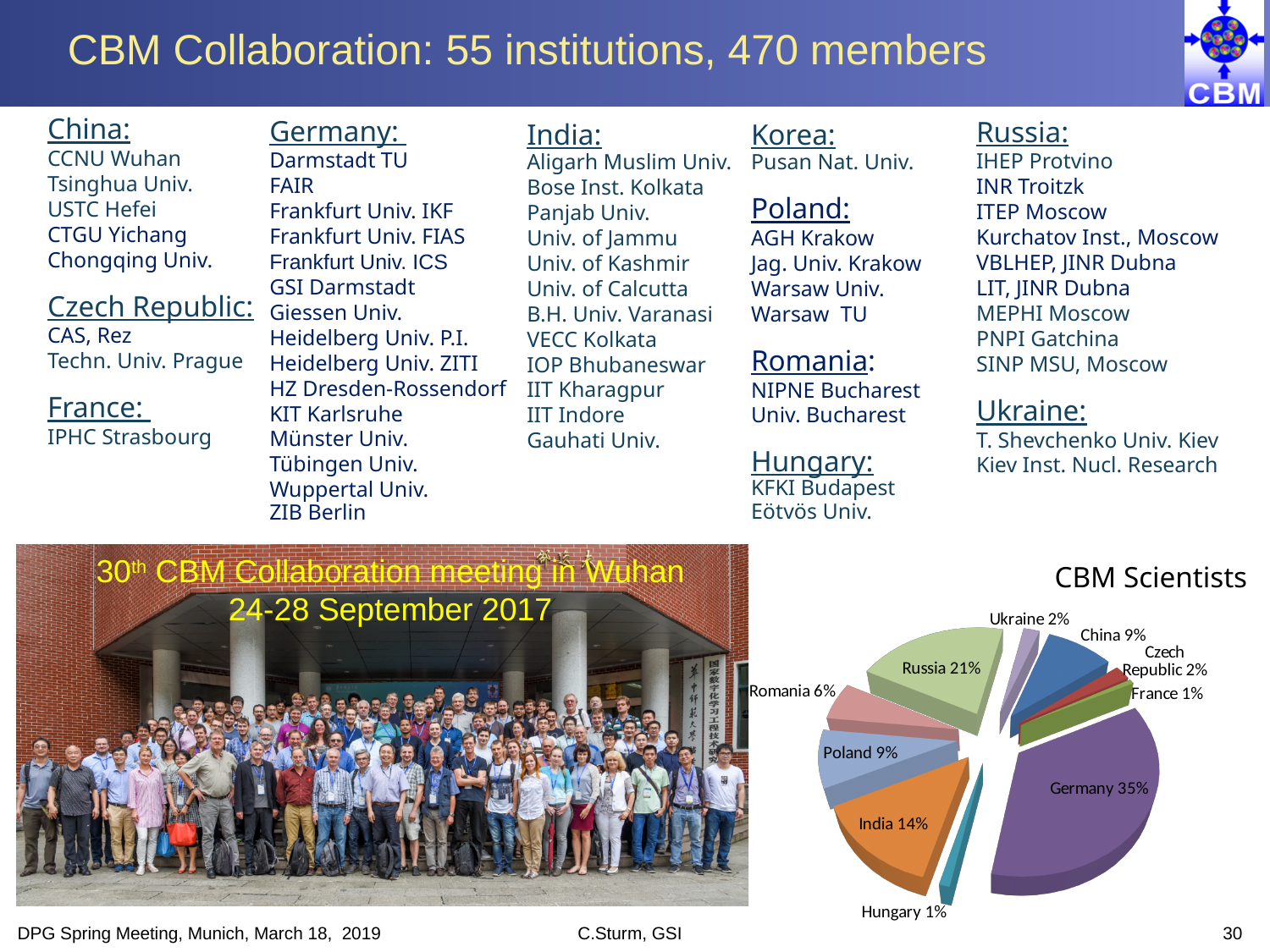
What kind of chart is used to show the CBM Scientists distribution? Pie chart What percentage of CBM Scientists is from Russia? 21% Which has a larger share of CBM Scientists, Russia or India? Russia What percentage of CBM Scientists is from India? 14% How many countries are labelled in the CBM Scientists pie chart? 10 What share of CBM Scientists is from Germany? 35% Which has a larger share of CBM Scientists, China or Romania? China What is the title of the chart in the lower right of the slide? CBM Scientists What is the difference in percentage points between the Germany and Russia shares of CBM Scientists? 14 What is the difference in percentage points between the India and Poland shares of CBM Scientists? 5 What percentage of CBM Scientists is from Romania? 6% Which country has the largest share of CBM Scientists? Germany